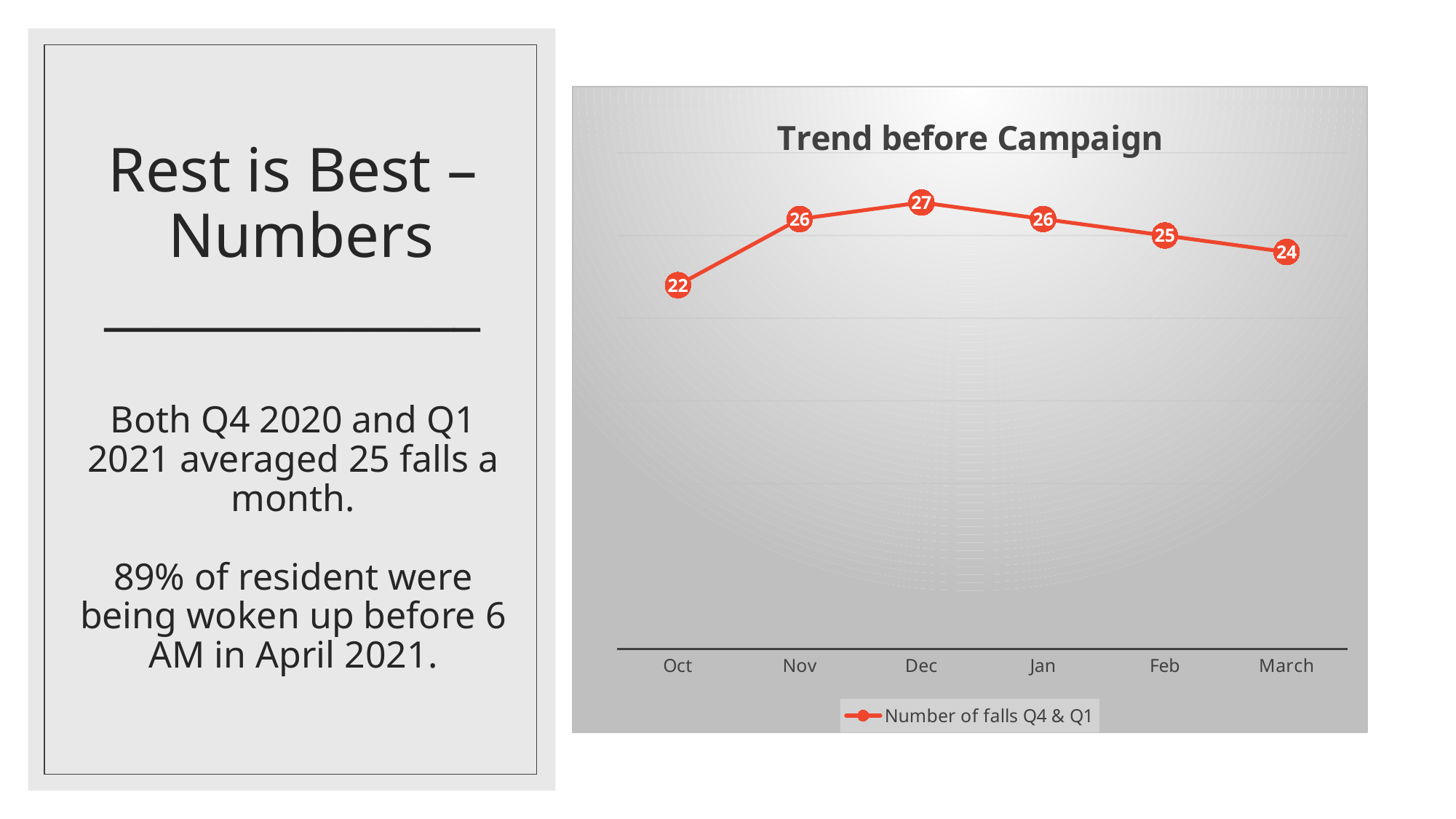
Do the values rise or fall from Dec to March? Fall What is the number of falls in March? 24 How many months are plotted on the chart? 6 How many series does the legend list? 1 What is the title of the chart? Trend before Campaign What is the number of falls in Dec? 27 Which month has the highest number of falls? Dec What is the difference between the number of falls in Dec and Oct? 5 What is the number of falls in Oct? 22 Which month has the lowest number of falls? Oct Which month has more falls, Nov or Feb? Nov What kind of chart is shown on the slide? Line chart